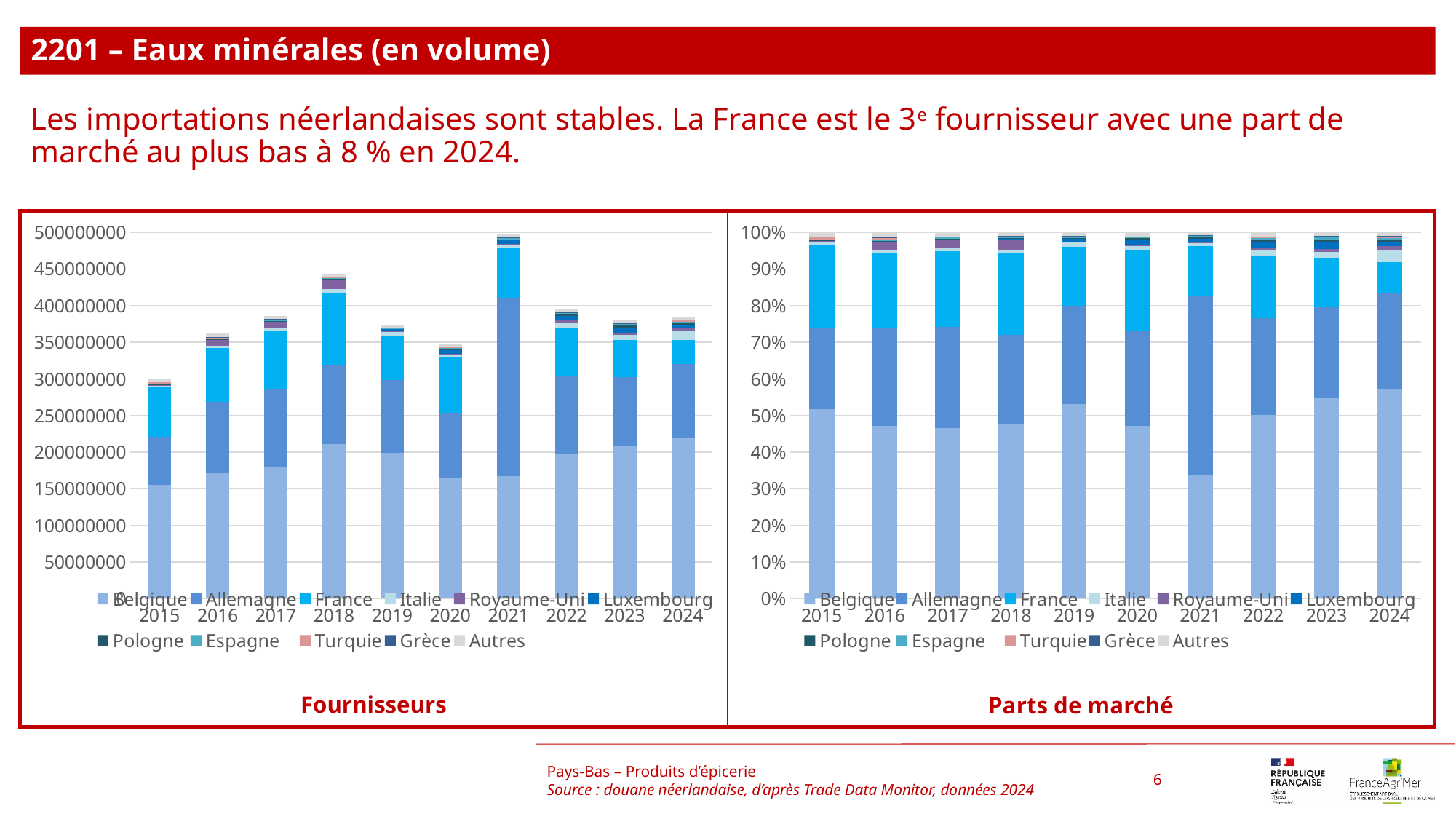
How many years are shown on the x axis of the "Fournisseurs" chart? 10 What kind of chart is the left chart titled "Fournisseurs"? stacked bar chart In the "Parts de marché" chart, is the Belgique share larger in 2021 or in 2024? 2024 What is the title of the right chart? Parts de marché How many series does the legend of the "Parts de marché" chart list? 11 In the "Fournisseurs" chart, which year has the tallest stacked bar? 2021 In the "Parts de marché" chart, is the Belgique share in 2024 greater or less than 50%? greater In the "Fournisseurs" chart, is the total for 2018 greater or less than 400000000? greater In the "Fournisseurs" chart, which year has the larger total, 2020 or 2021? 2021 In the "Fournisseurs" chart, is the total for 2021 greater or less than 450000000? greater In the "Fournisseurs" chart, which year has the shortest stacked bar? 2015